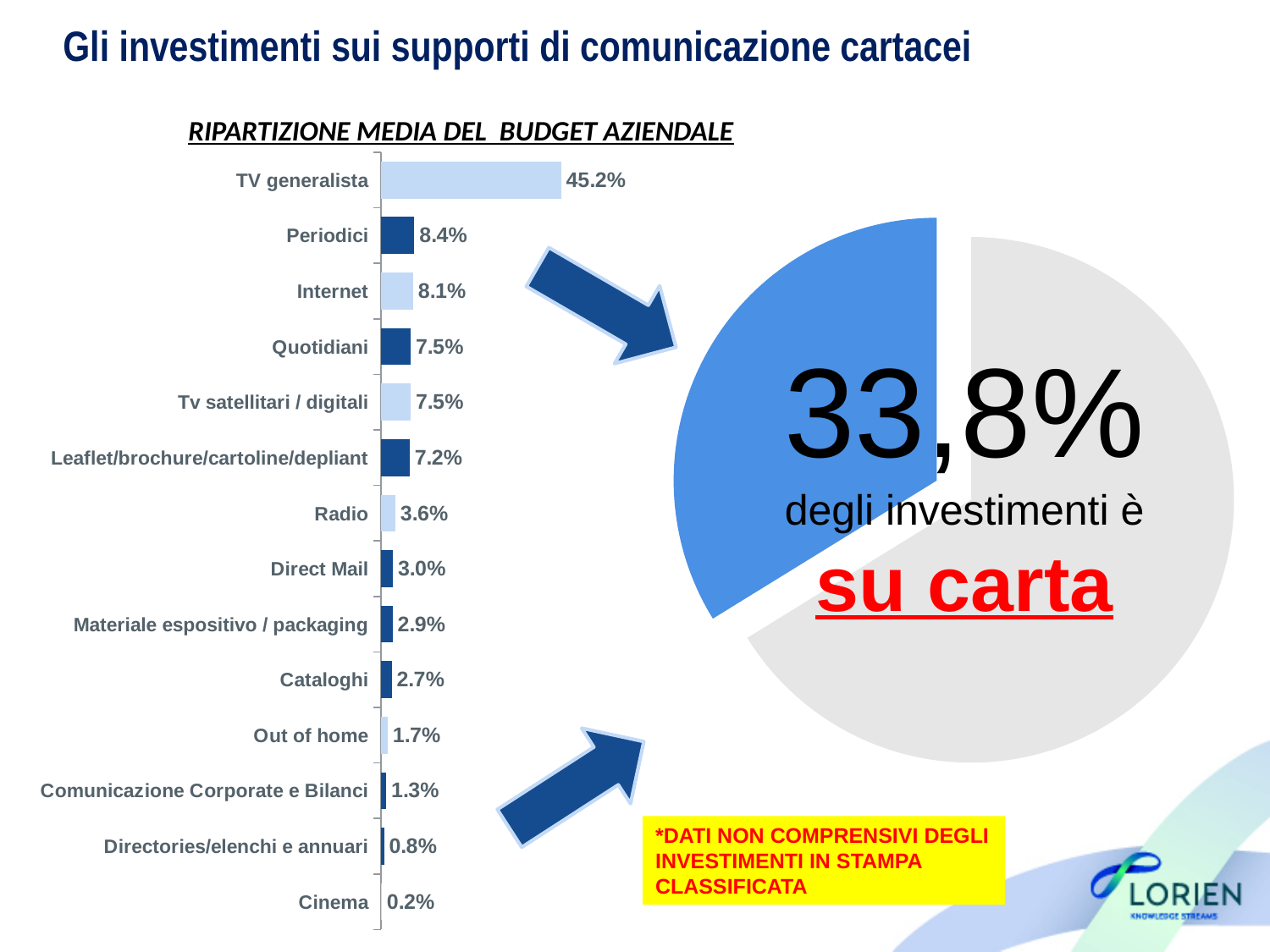
How many categories are shown in the bar chart 'Ripartizione media del budget aziendale'? 14 In the bar chart 'Ripartizione media del budget aziendale', what is the value for Leaflet/brochure/cartoline/depliant? 7.2% In the bar chart 'Ripartizione media del budget aziendale', what is the difference between the values for TV generalista and Radio? 41.6% In the bar chart 'Ripartizione media del budget aziendale', which category has the highest value? TV generalista In the bar chart 'Ripartizione media del budget aziendale', what is the difference between the values for Periodici and Internet? 0.3% What kind of chart is shown on the right side of the slide? Pie chart What kind of chart is 'Ripartizione media del budget aziendale'? Bar chart In the bar chart 'Ripartizione media del budget aziendale', which is larger: the value for Direct Mail or the value for Out of home? Direct Mail In the bar chart 'Ripartizione media del budget aziendale', what is the value for TV generalista? 45.2% In the pie chart on the right, what share of investments is 'su carta'? 33,8% In the bar chart 'Ripartizione media del budget aziendale', what is the value for Cataloghi? 2.7% In the bar chart 'Ripartizione media del budget aziendale', which category has the lowest value? Cinema